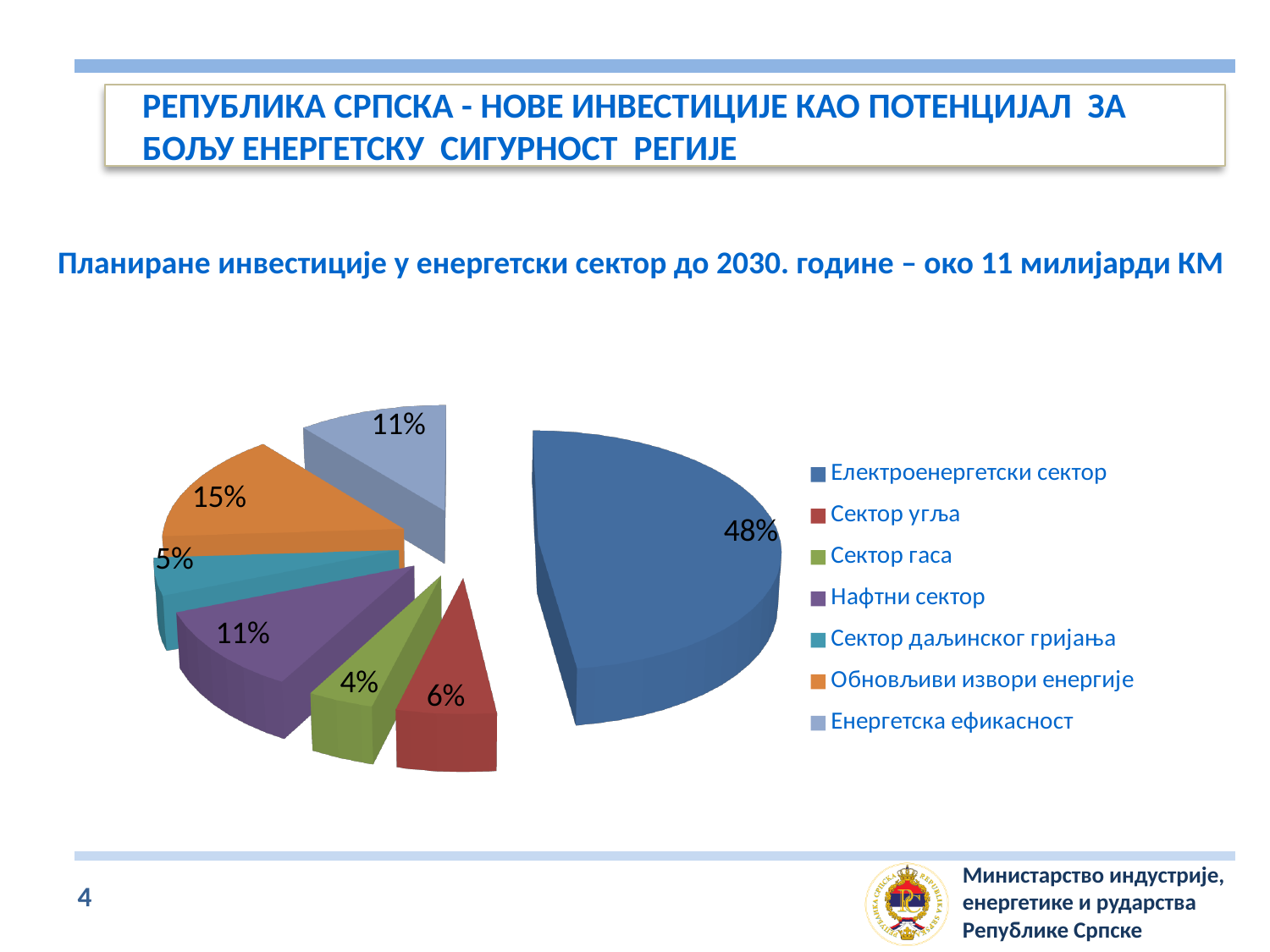
What share of the pie does Сектор гаса hold? 4% Which sector has the smallest share of the pie? Сектор гаса What is the difference in percentage points between Електроенергетски сектор and Обновљиви извори енергије? 33 How many slices does the pie chart have? 7 What share of the pie does Обновљиви извори енергије hold? 15% What share of the pie does Електроенергетски сектор hold? 48% Which colour represents Нафтни сектор in the legend? Purple Which has a larger share, Сектор угља or Нафтни сектор? Нафтни сектор Which sector has the largest share of the pie? Електроенергетски сектор What kind of chart is shown on the slide? Pie chart